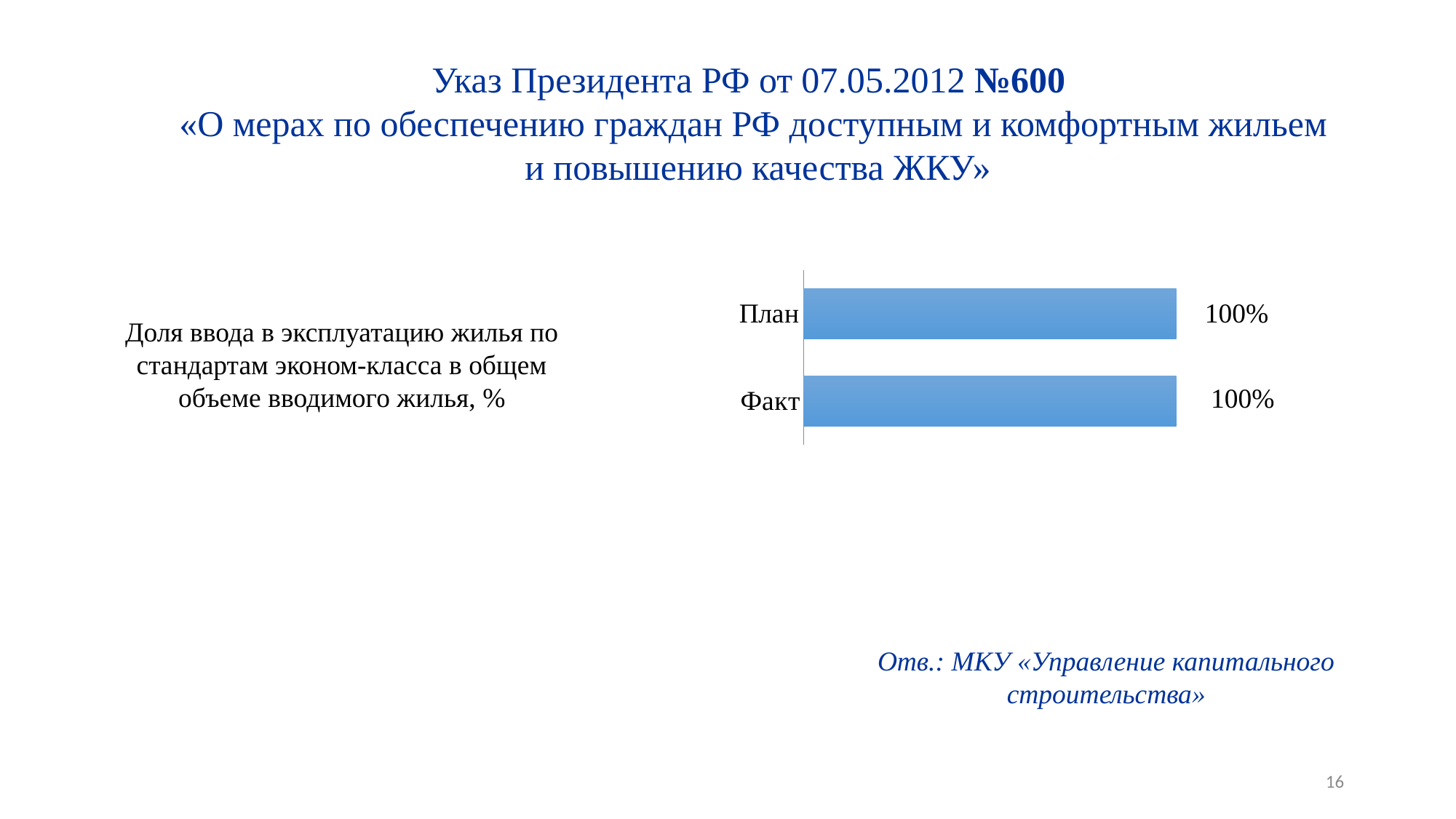
Are the bars in the chart horizontal or vertical? horizontal What colour are the bars in the chart? blue What kind of chart is shown on the slide? bar chart What is the value for План? 100% Is the value for Факт equal to the value for План? yes How many bars does the chart show? 2 What is the difference between the values for План and Факт? 0% What is the value for Факт? 100%